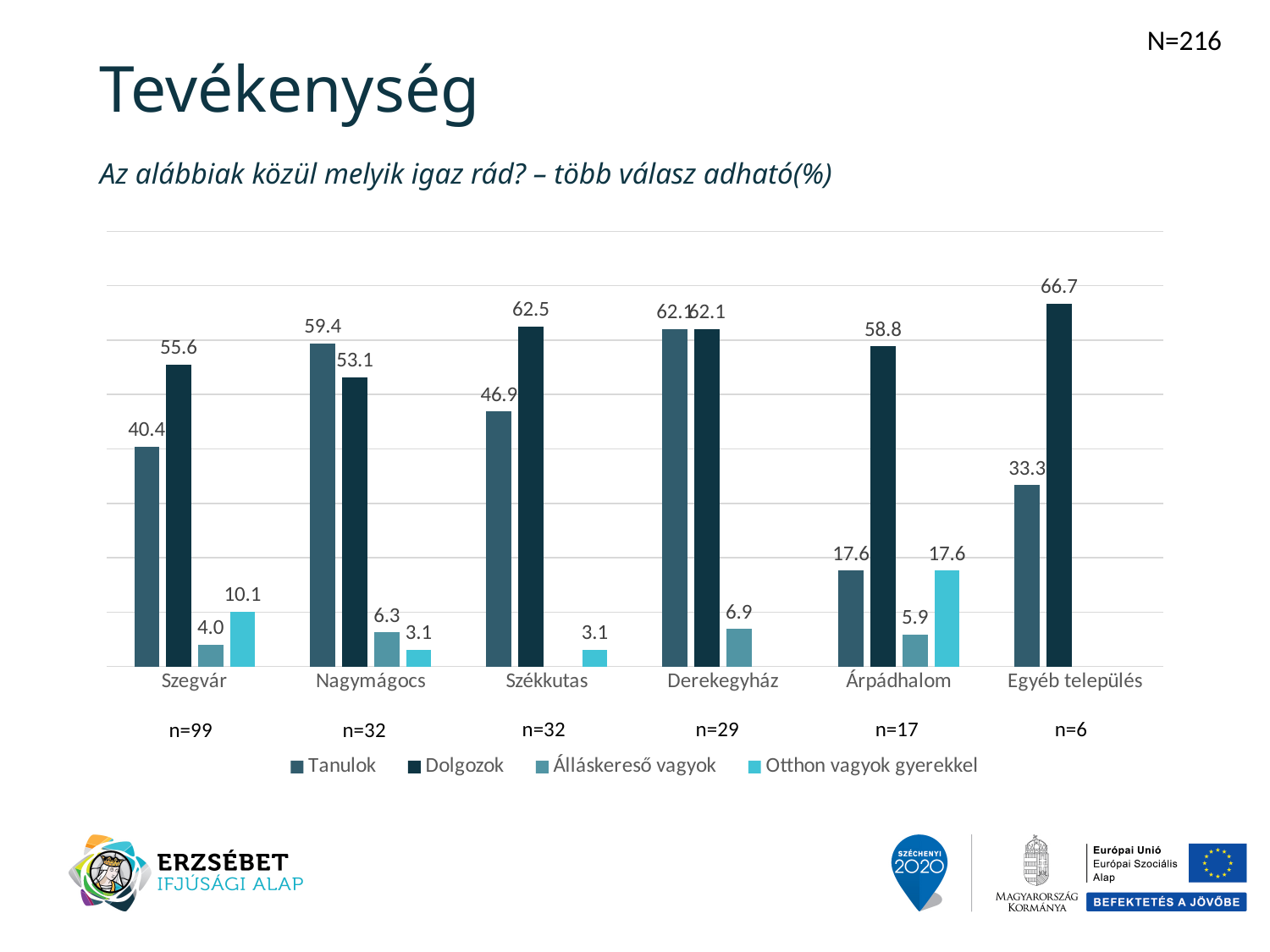
What is the value for Tanulok in Nagymágocs? 59.4 What is the value for Álláskereső vagyok in Derekegyház? 6.9 Which category has the highest value for Dolgozok? Egyéb település Which category has the lowest value for Tanulok? Árpádhalom What is the value for Otthon vagyok gyerekkel in Árpádhalom? 17.6 What is the sample size (n) shown for Szegvár? n=99 How many series does the legend list? 4 Which is larger in Nagymágocs: Tanulok or Dolgozok? Tanulok What is the value for Dolgozok in Szegvár? 55.6 What kind of chart is shown on the slide? Bar chart What is the difference between the Dolgozok and Tanulok values in Egyéb település? 33.4 How many categories (settlements) are shown on the x axis? 6